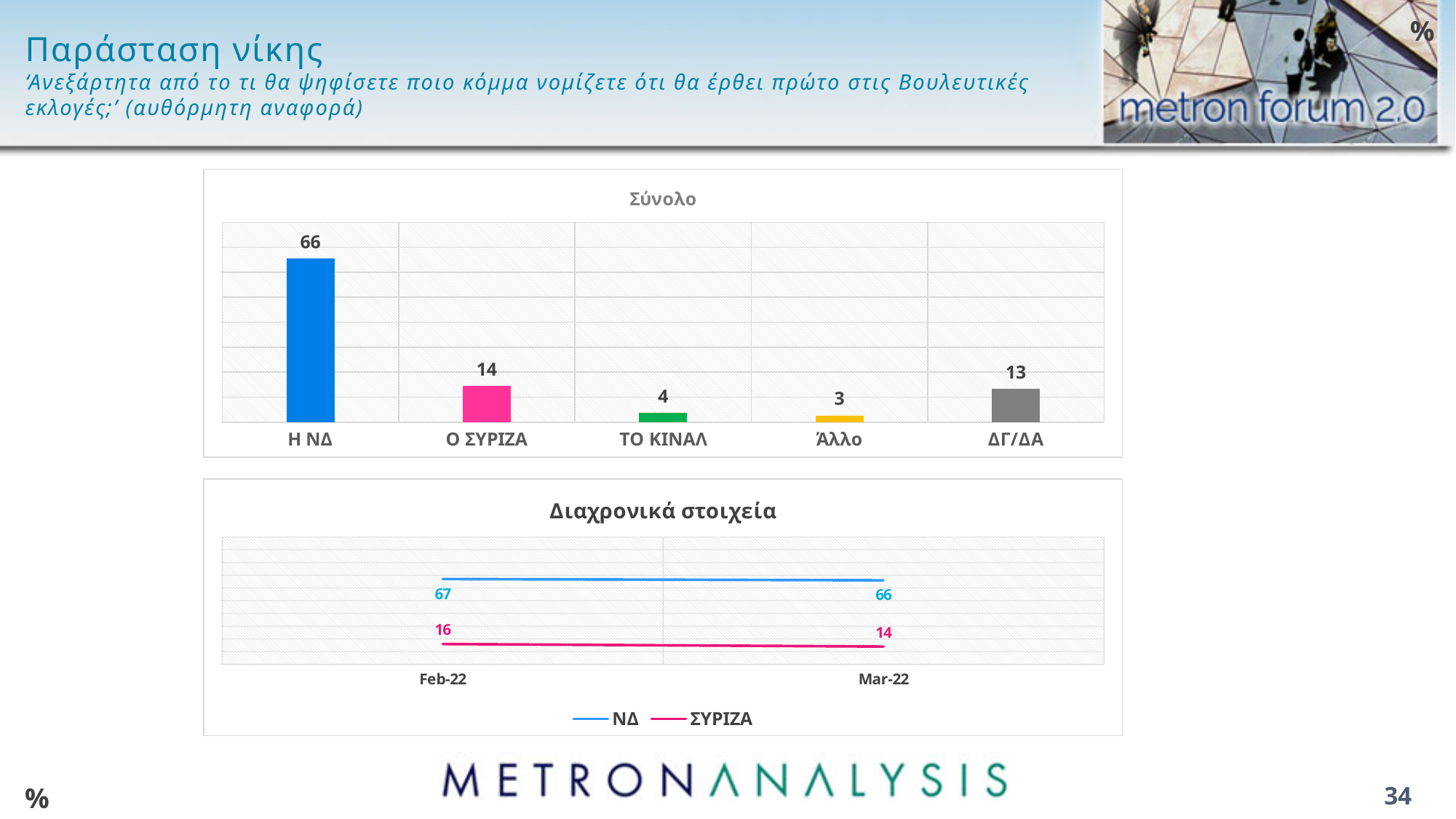
In the 'Σύνολο' bar chart, which category has the lowest value? Άλλο In the 'Διαχρονικά στοιχεία' chart, does the ΣΥΡΙΖΑ line rise or fall from Feb-22 to Mar-22? Fall In the 'Σύνολο' bar chart, what is the value for ΔΓ/ΔΑ? 13 In the 'Διαχρονικά στοιχεία' chart, what is the value for ΝΔ in Feb-22? 67 In the 'Σύνολο' bar chart, which category has the highest value? Η ΝΔ How many series does the legend of the 'Διαχρονικά στοιχεία' chart list? 2 In the 'Σύνολο' bar chart, what is the value for Η ΝΔ? 66 How many categories are shown in the 'Σύνολο' bar chart? 5 What kind of chart is the 'Σύνολο' chart? Bar chart In the 'Διαχρονικά στοιχεία' chart, what is the value for ΣΥΡΙΖΑ in Mar-22? 14 In the 'Σύνολο' bar chart, what is the difference between the values for Η ΝΔ and Ο ΣΥΡΙΖΑ? 52 In the 'Σύνολο' bar chart, which is larger: the value for Ο ΣΥΡΙΖΑ or the value for ΔΓ/ΔΑ? Ο ΣΥΡΙΖΑ